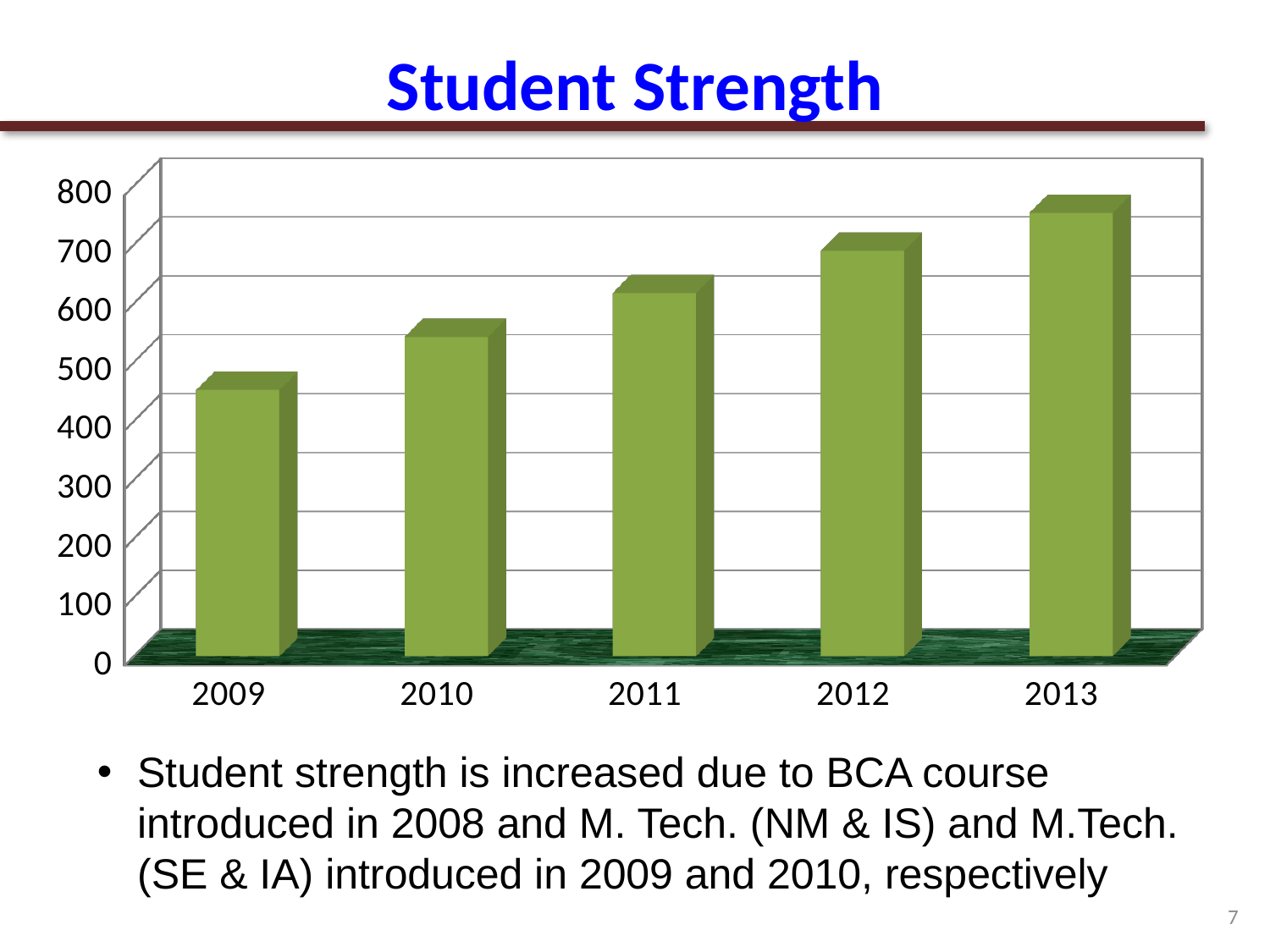
What is the title of the chart on the slide? Student Strength What kind of chart is shown on the slide? bar chart Which year has the lowest student strength? 2009 Is the value for 2013 greater or less than 700? greater Which year has the highest student strength? 2013 Is the value for 2009 greater or less than 400? greater Is the value for 2009 greater or less than 500? less Do the values rise or fall from 2009 to 2013? rise How many years are shown on the x axis of the chart? 5 Which is larger, the value for 2012 or the value for 2010? 2012